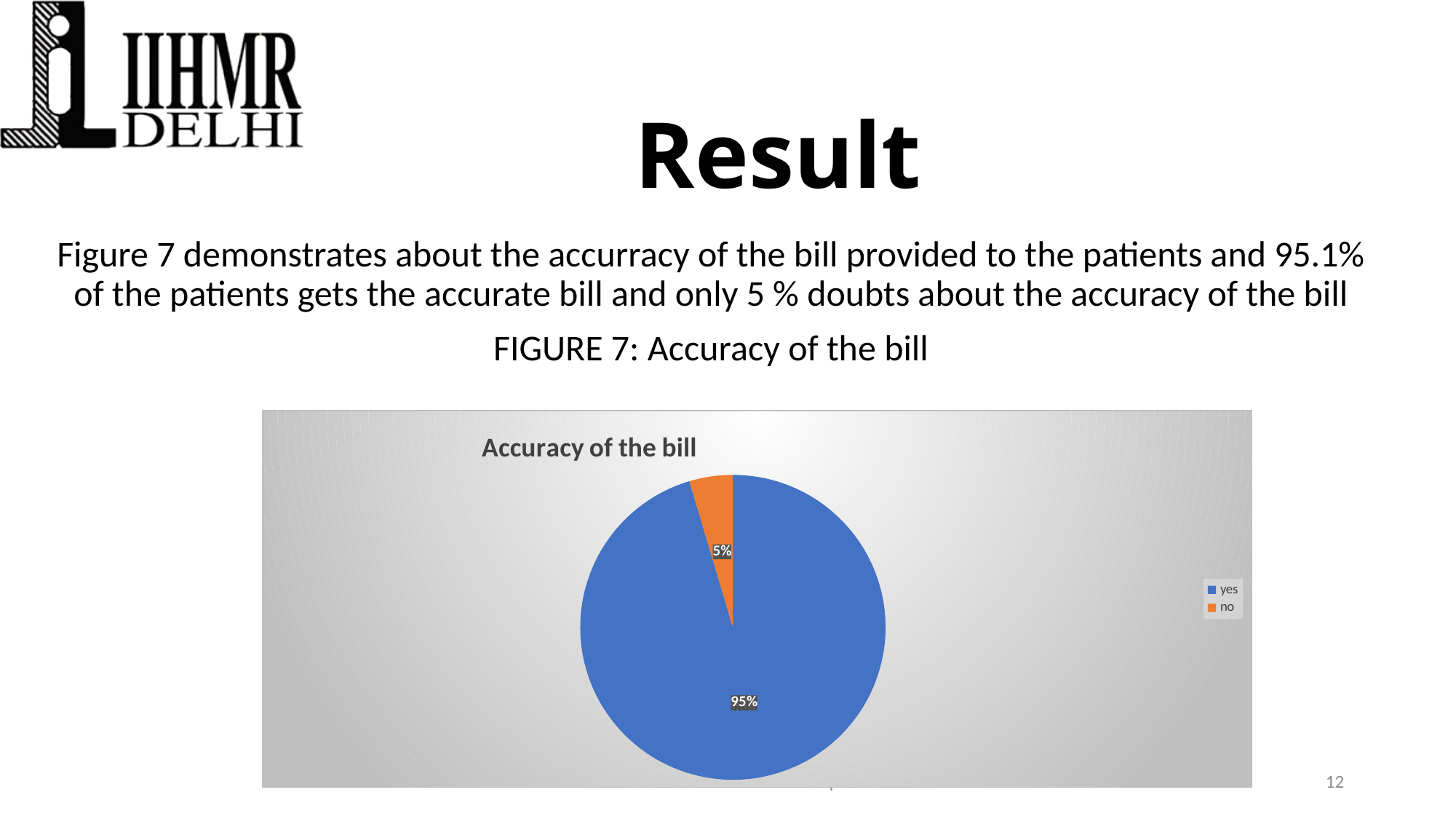
What is the difference in percentage points between the "yes" and "no" slices? 90 How many slices does the pie chart have? 2 What kind of chart is shown on the slide? pie chart How many entries does the legend list? 2 What is the title of the chart? Accuracy of the bill Which slice of the pie is the smallest? no Which is larger, the "yes" slice or the "no" slice? yes What share of the pie is labelled "no"? 5% Which slice of the pie is the largest? yes What colour is the "no" slice in the pie chart? orange What share of the pie is labelled "yes"? 95%